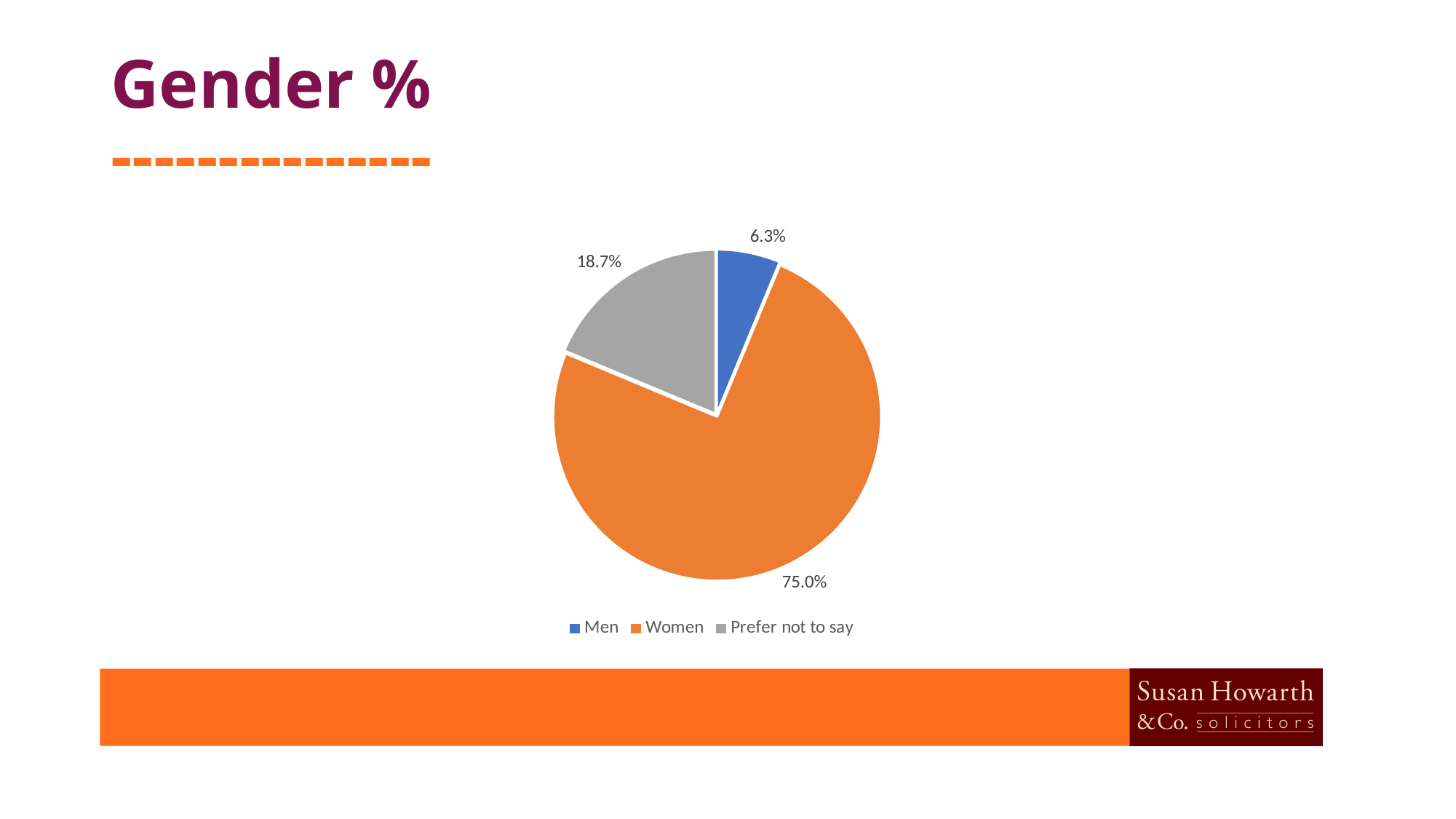
What is the title of the slide containing the chart? Gender % Which category has the largest share of the pie? Women What kind of chart is shown on the slide? pie chart What colour is the Women slice of the pie? orange What is the difference between the Women share and the Prefer not to say share? 56.3% What percentage of the pie is Prefer not to say? 18.7% What is the difference between the Prefer not to say share and the Men share? 12.4% What percentage of the pie is Women? 75.0% How many categories does the pie chart have? 3 Which is larger, the share for Men or the share for Prefer not to say? Prefer not to say What percentage of the pie is Men? 6.3% Which category has the smallest share of the pie? Men